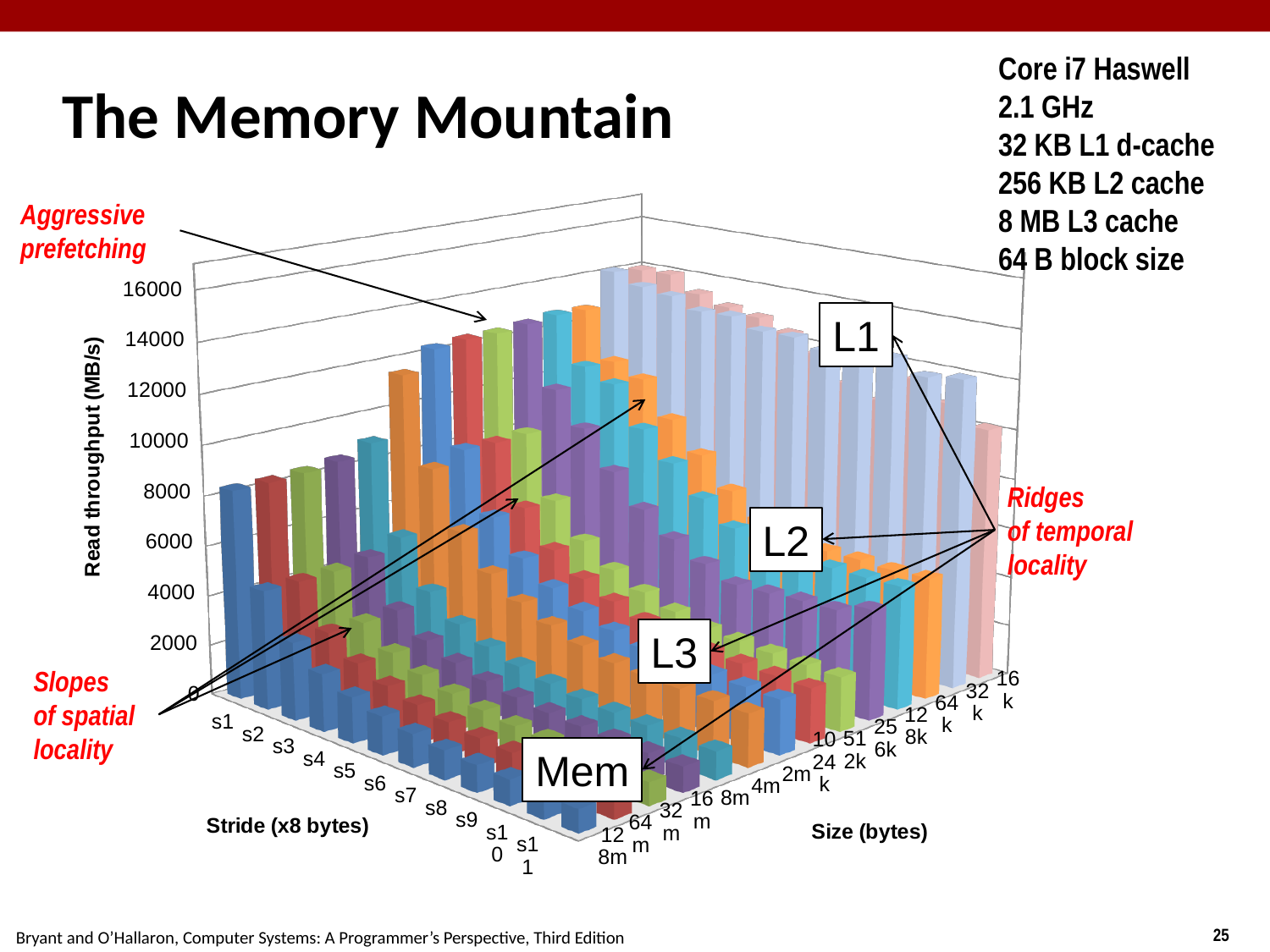
What is the title of the chart on the slide? The Memory Mountain What is the label of the vertical axis of the chart? Read throughput (MB/s) Along the stride axis for the largest size (128m, the front row), does read throughput rise or fall as stride increases from s1 to s11? fall How many stride categories (s1 through s11) are shown along the stride axis? 11 Which size has the higher read throughput at stride s1: 32k or 128m? 32k Is the read throughput for stride s1 at size 32k greater or less than 12000? greater Is the read throughput for stride s11 at size 128m greater or less than 4000? less What kind of chart is shown on the slide? 3D bar chart Which stride has the highest read throughput for size 128m: s1 or s11? s1 What is the highest tick value shown on the read throughput axis? 16000